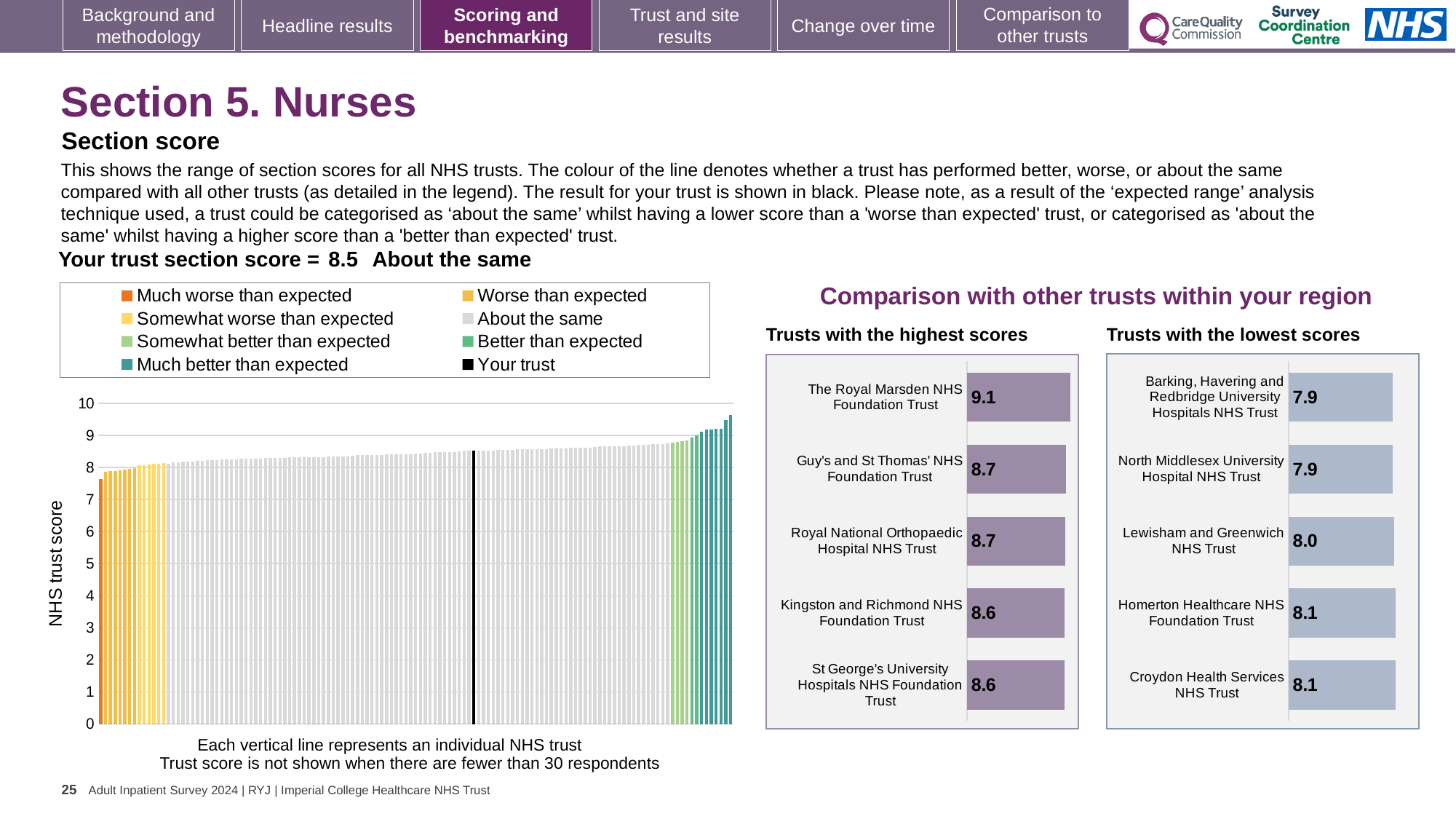
In the 'Trusts with the lowest scores' chart, which is larger: the score for Lewisham and Greenwich NHS Trust or Homerton Healthcare NHS Foundation Trust? Homerton Healthcare NHS Foundation Trust In the main 'NHS trust score' chart on the left, how many entries does the legend list? 8 In the 'Trusts with the highest scores' chart, how many trusts are listed? 5 In the 'Trusts with the highest scores' chart, what is the difference between the scores of The Royal Marsden NHS Foundation Trust and Kingston and Richmond NHS Foundation Trust? 0.5 In the 'Trusts with the lowest scores' chart, what is the score for Lewisham and Greenwich NHS Trust? 8.0 In the main 'NHS trust score' chart on the left, is the value of the lowest (leftmost) bar greater or less than 8? less In the main 'NHS trust score' chart on the left, what kind of chart is it? Bar chart In the 'Trusts with the lowest scores' chart, what is the difference between the scores of Croydon Health Services NHS Trust and Barking, Havering and Redbridge University Hospitals NHS Trust? 0.2 In the 'Trusts with the highest scores' chart, what is the score for The Royal Marsden NHS Foundation Trust? 9.1 In the 'Trusts with the highest scores' chart, which trust has the highest score? The Royal Marsden NHS Foundation Trust In the 'Trusts with the highest scores' chart, what is the score for Kingston and Richmond NHS Foundation Trust? 8.6 In the 'Trusts with the lowest scores' chart, what is the score for Croydon Health Services NHS Trust? 8.1